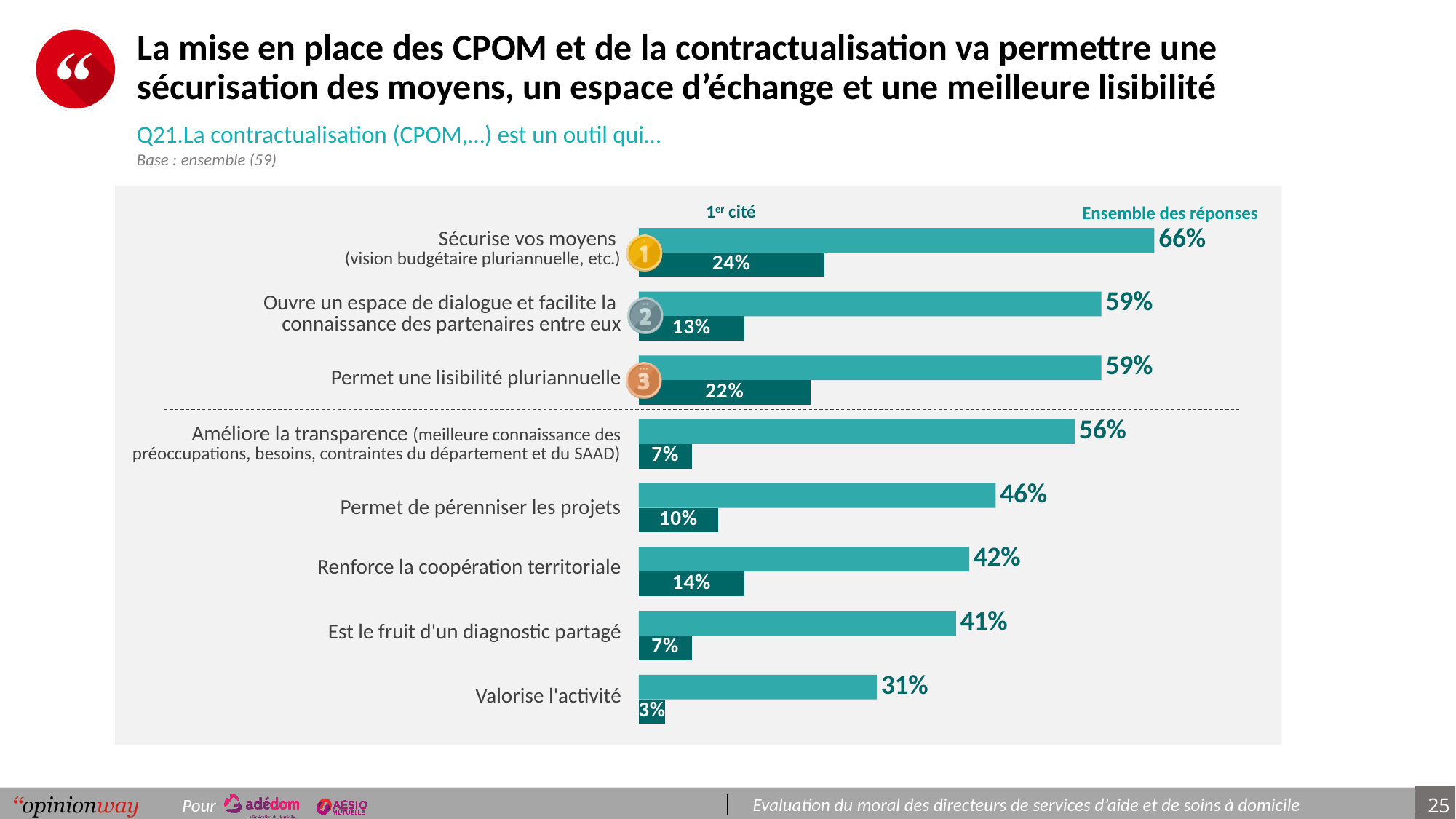
What is the difference between the 'Ensemble des réponses' values for 'Sécurise vos moyens' and 'Valorise l'activité'? 35% How many series does the chart show? 2 Which category has the highest 'Ensemble des réponses' value? Sécurise vos moyens Which category has the lowest '1er cité' value? Valorise l'activité Which has the larger '1er cité' value: 'Sécurise vos moyens' or 'Ouvre un espace de dialogue et facilite la connaissance des partenaires entre eux'? Sécurise vos moyens What is the '1er cité' value for 'Renforce la coopération territoriale'? 14% What is the 'Ensemble des réponses' value for 'Sécurise vos moyens'? 66% What is the difference between the 'Ensemble des réponses' and '1er cité' values for 'Permet de pérenniser les projets'? 36% How many categories (statements) are plotted in the chart? 8 What kind of chart is shown on the slide? Bar chart What are the two series names shown above the bars? 1er cité and Ensemble des réponses What is the '1er cité' value for 'Permet une lisibilité pluriannuelle'? 22%